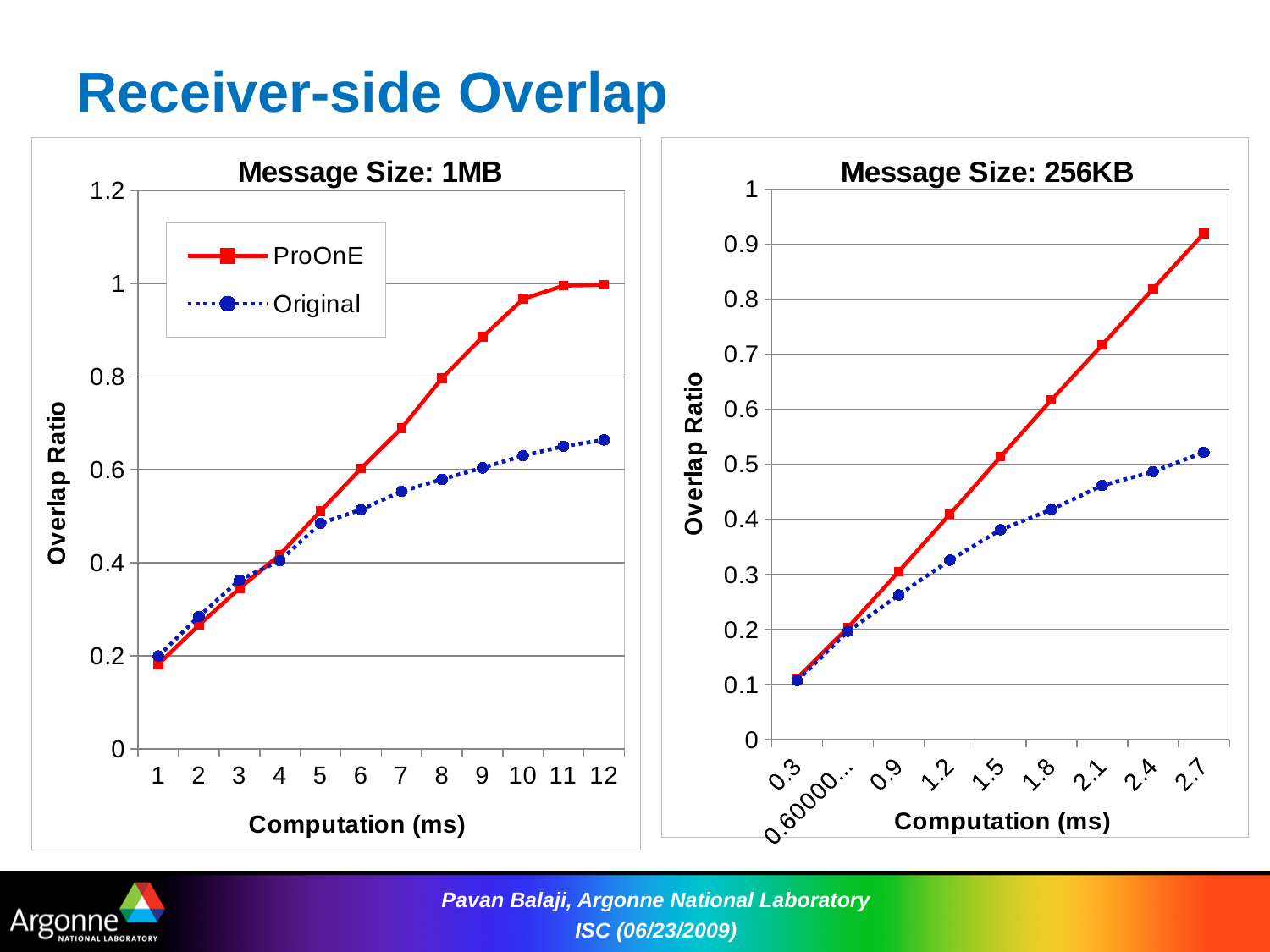
In the 'Message Size: 256KB' chart, is the Original value at 2.7 ms greater or less than 0.6? less In the 'Message Size: 1MB' chart, how many computation values are shown on the x axis? 12 In the 'Message Size: 256KB' chart, is the ProOnE value at 2.7 ms greater or less than 0.8? greater In the 'Message Size: 256KB' chart, which series has the higher overlap ratio at 1.8 ms? ProOnE In the 'Message Size: 1MB' chart, is the ProOnE value at 8 ms greater or less than 0.6? greater What kind of chart is the 'Message Size: 1MB' chart? line chart What is the y-axis label of the 'Message Size: 256KB' chart? Overlap Ratio What is the title of the chart on the right? Message Size: 256KB In the 'Message Size: 1MB' chart, does the ProOnE overlap ratio rise or fall as computation increases? rise In the 'Message Size: 1MB' chart, which series has the higher overlap ratio at 10 ms? ProOnE How many series does the legend list in the 'Message Size: 1MB' chart? 2